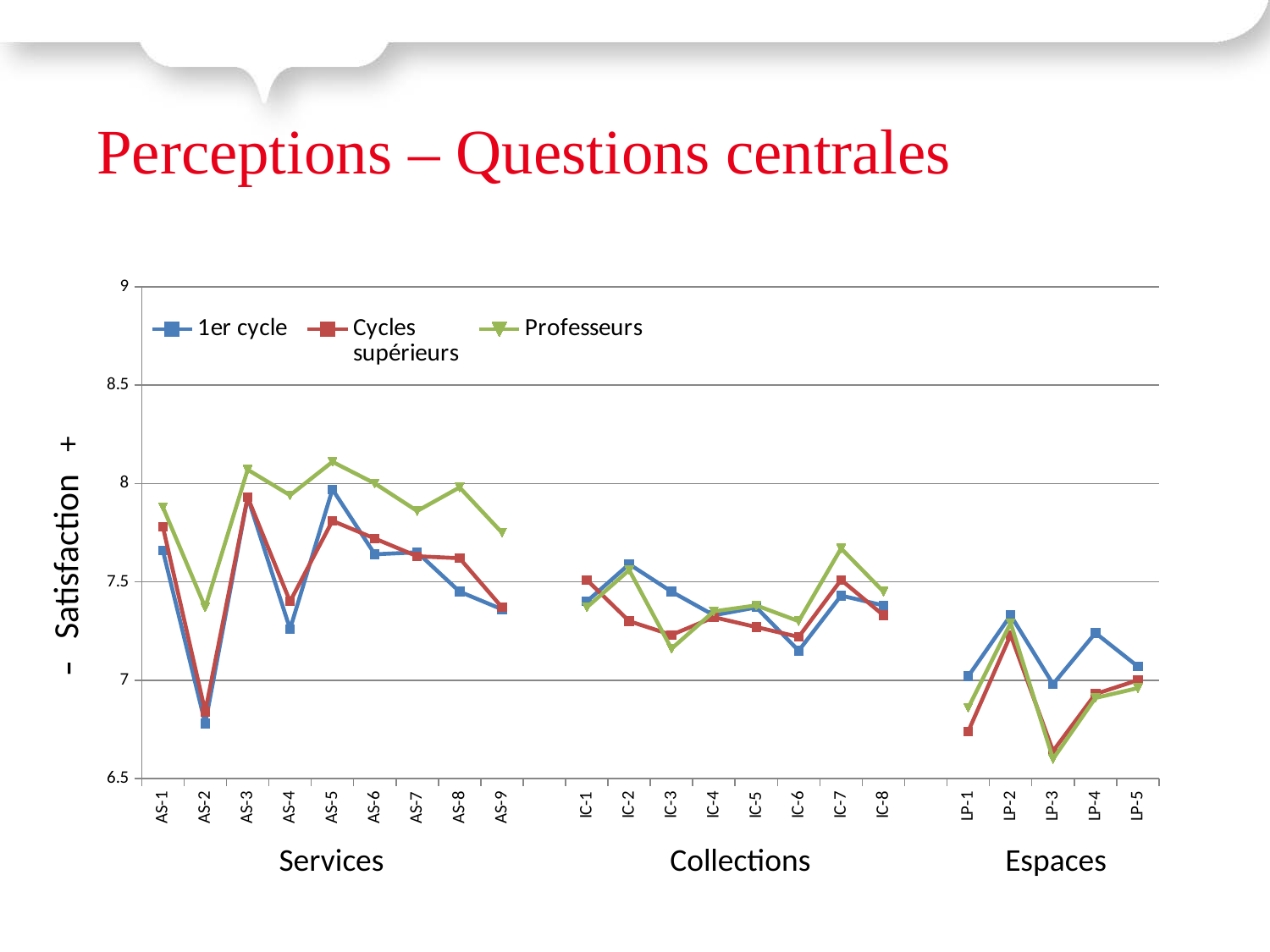
At AS-9, which series has the higher value, Professeurs or 1er cycle? Professeurs How many series does the legend list? 3 How many categories are plotted along the x axis in total? 22 What are the three group labels shown below the x axis? Services, Collections, Espaces Which series are listed in the legend? 1er cycle, Cycles supérieurs, Professeurs Is the value for Professeurs at AS-5 greater or less than 8? greater How many categories are in the Services group? 9 Is the value for 1er cycle at AS-2 greater or less than 7? less Is the value for 1er cycle at IC-6 greater or less than 7.5? less What kind of chart is shown on the slide? line chart At which category does the Professeurs series reach its lowest value? LP-3